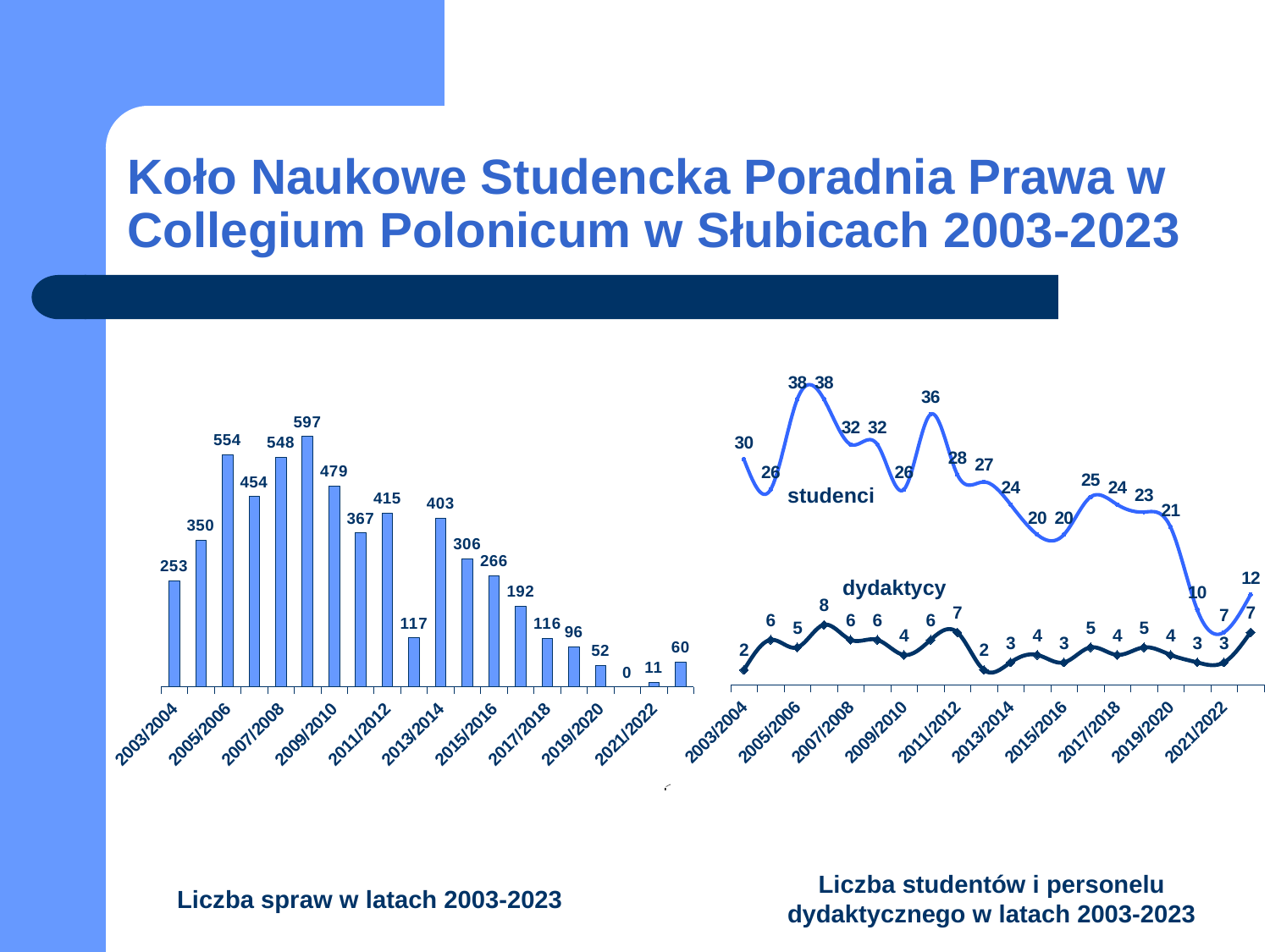
In the chart 'Liczba studentów i personelu dydaktycznego w latach 2003-2023', what is the value of the 'studenci' series for 2003/2004? 30 How many series are plotted in the chart 'Liczba studentów i personelu dydaktycznego w latach 2003-2023'? 2 In the chart 'Liczba spraw w latach 2003-2023', what is the value for 2003/2004? 253 In the chart 'Liczba spraw w latach 2003-2023', how many bars are plotted? 20 In the chart 'Liczba studentów i personelu dydaktycznego w latach 2003-2023', which series has the larger value for 2021/2022, 'studenci' or 'dydaktycy'? studenci In the chart 'Liczba spraw w latach 2003-2023', what is the lowest value shown? 0 In the chart 'Liczba spraw w latach 2003-2023', what is the value for 2005/2006? 554 In the chart 'Liczba spraw w latach 2003-2023', what is the highest value shown? 597 In the chart 'Liczba studentów i personelu dydaktycznego w latach 2003-2023', what is the value of the 'dydaktycy' series for 2011/2012? 7 In the chart 'Liczba studentów i personelu dydaktycznego w latach 2003-2023', what is the highest value of the 'studenci' series? 38 In the chart 'Liczba spraw w latach 2003-2023', what is the difference between the values for 2005/2006 and 2003/2004? 301 What kind of chart is 'Liczba spraw w latach 2003-2023'? Bar chart